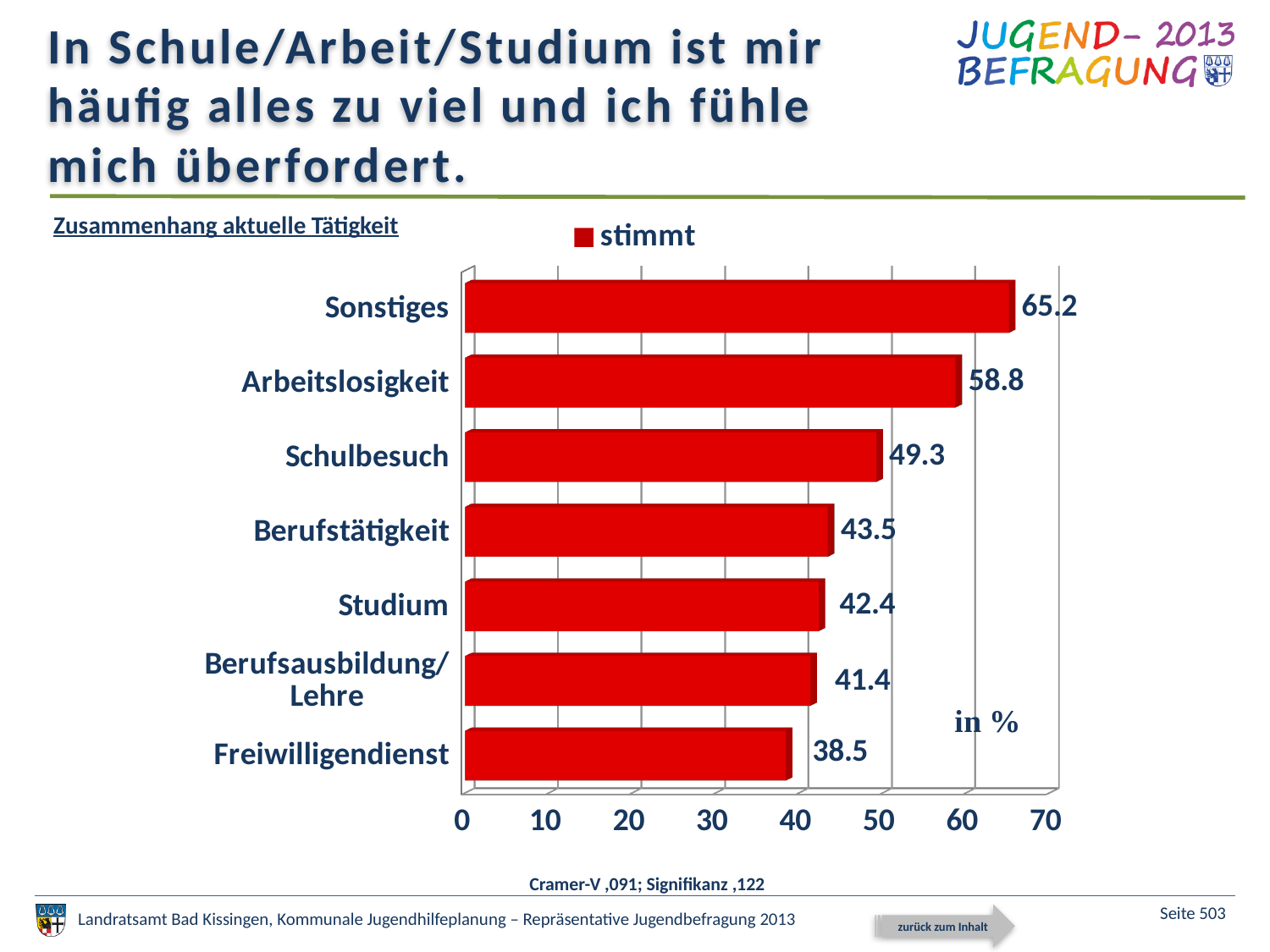
What is the difference between the values for Arbeitslosigkeit and Schulbesuch? 9.5 Which category has the highest value? Sonstiges What is the value for Sonstiges? 65.2 How many categories are shown in the chart? 7 What is the value for Freiwilligendienst? 38.5 What is the value for Schulbesuch? 49.3 What is the value for Berufsausbildung/Lehre? 41.4 What series name does the legend show? stimmt Which category has the lowest value? Freiwilligendienst What kind of chart is shown on the slide? bar chart Which is larger, the value for Berufstätigkeit or the value for Studium? Berufstätigkeit Is the value for Arbeitslosigkeit greater or less than 50? greater